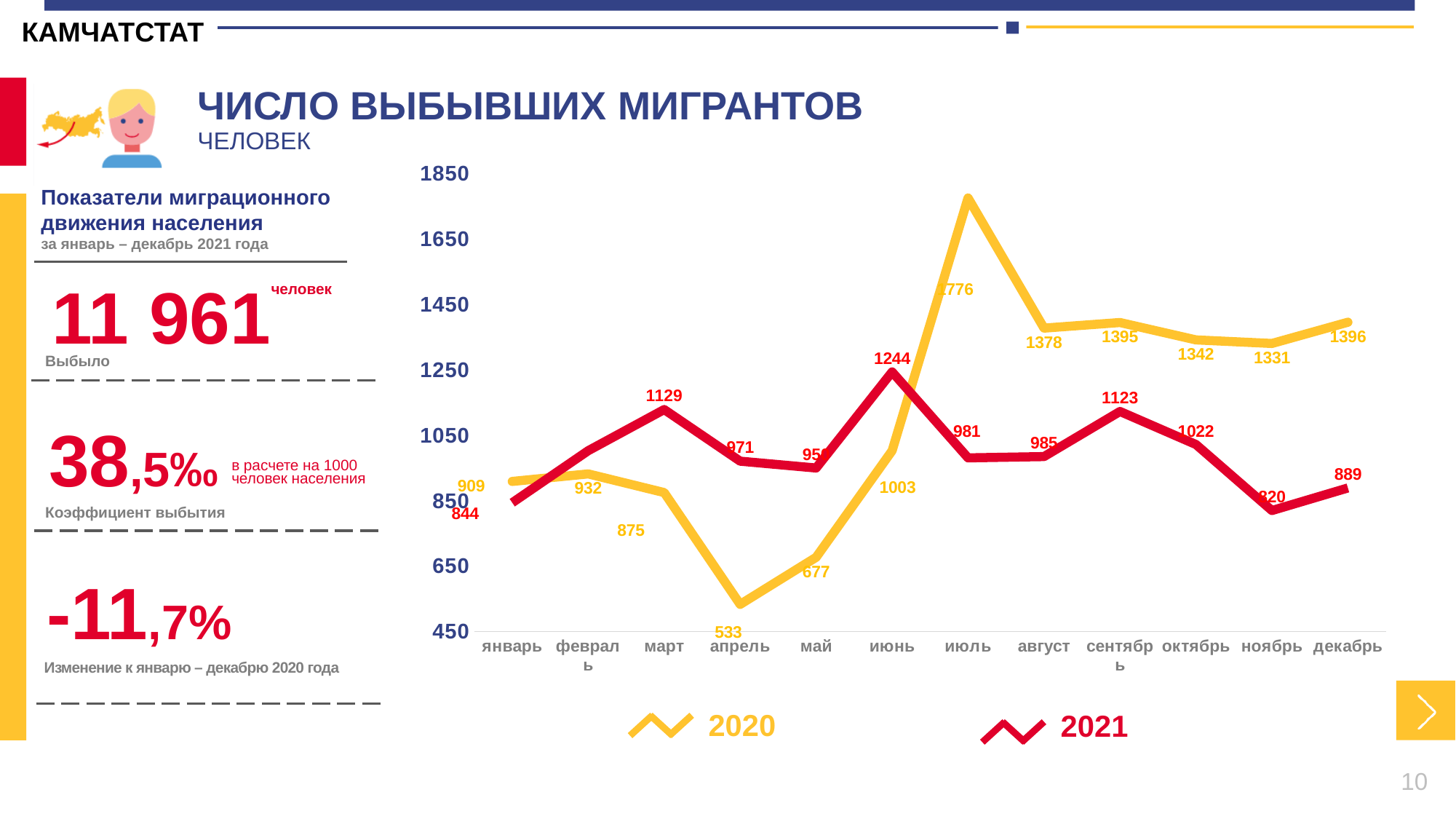
Which month has the highest value in the 2021 series? июнь Is the value for июль in the 2020 series greater or less than 1650? greater What is the difference between the 2021 values for март and апрель? 158 What is the value for июнь in the 2021 series? 1244 What is the value for декабрь in the 2020 series? 1396 What kind of chart is shown on the slide? line chart What colour is the line for the 2021 series? red For сентябрь, which series has the larger value, 2020 or 2021? 2020 Which month has the lowest value in the 2020 series? апрель How many months are plotted along the x axis? 12 What is the value for апрель in the 2020 series? 533 How many series does the legend list? 2